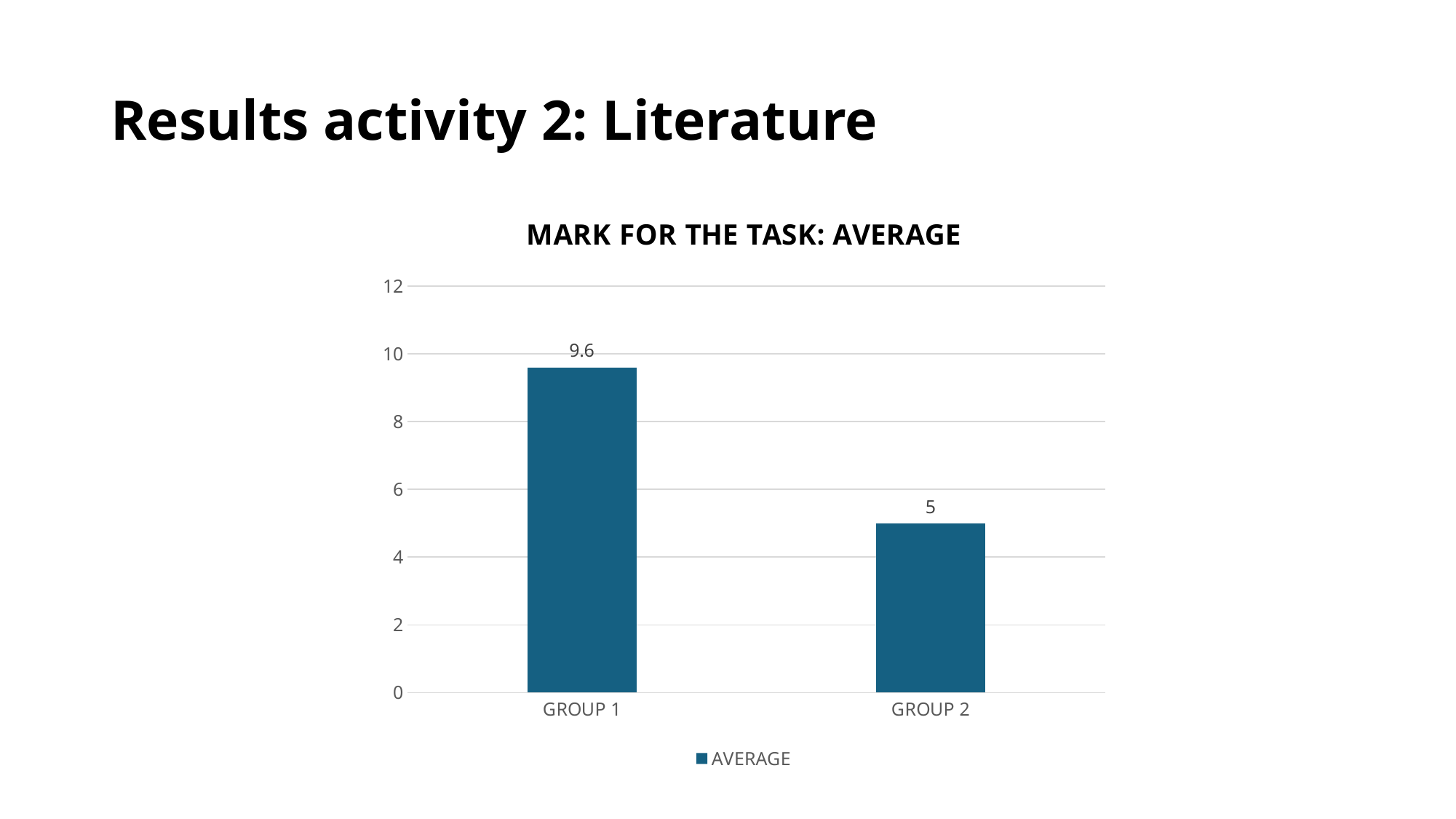
Which group has a larger average mark, GROUP 1 or GROUP 2? GROUP 1 Which group has the highest average mark? GROUP 1 What is the title of the chart? MARK FOR THE TASK: AVERAGE What is the average mark for GROUP 1? 9.6 How many groups are shown in the chart? 2 Is the value for GROUP 2 greater or less than 6? less What is the difference between the average marks of GROUP 1 and GROUP 2? 4.6 What is the average mark for GROUP 2? 5 Is the value for GROUP 1 greater or less than 8? greater What kind of chart is shown on the slide? Bar chart Which group has the lowest average mark? GROUP 2 How many series does the legend list? 1